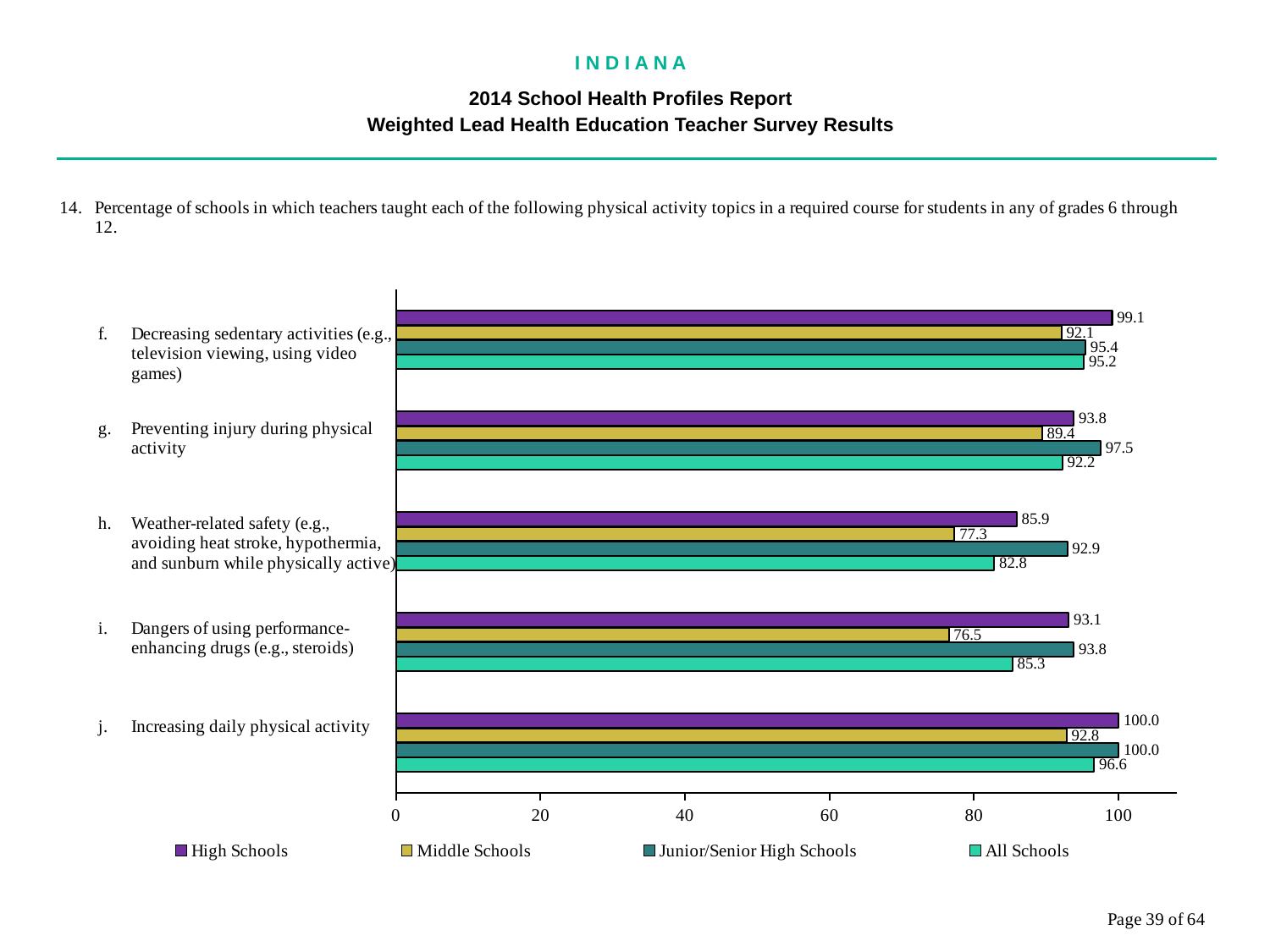
How many physical activity topics are shown on the chart? 5 Which topic has the highest value for Middle Schools? Increasing daily physical activity What is the difference between the High Schools and Middle Schools values for 'Dangers of using performance-enhancing drugs (e.g., steroids)'? 16.6 How many series does the legend list? 4 What is the value for Junior/Senior High Schools for 'Preventing injury during physical activity'? 97.5 What is the value for Middle Schools for 'Weather-related safety (e.g., avoiding heat stroke, hypothermia, and sunburn while physically active)'? 77.3 Is the Middle Schools value for 'Weather-related safety' greater or less than 80? less What kind of chart is shown on the slide? bar chart What is the value for All Schools for 'Dangers of using performance-enhancing drugs (e.g., steroids)'? 85.3 For 'Preventing injury during physical activity', which is larger: the High Schools value or the Junior/Senior High Schools value? Junior/Senior High Schools Which topic has the lowest value for All Schools? Weather-related safety (e.g., avoiding heat stroke, hypothermia, and sunburn while physically active) Which series is shown in purple in the legend? High Schools